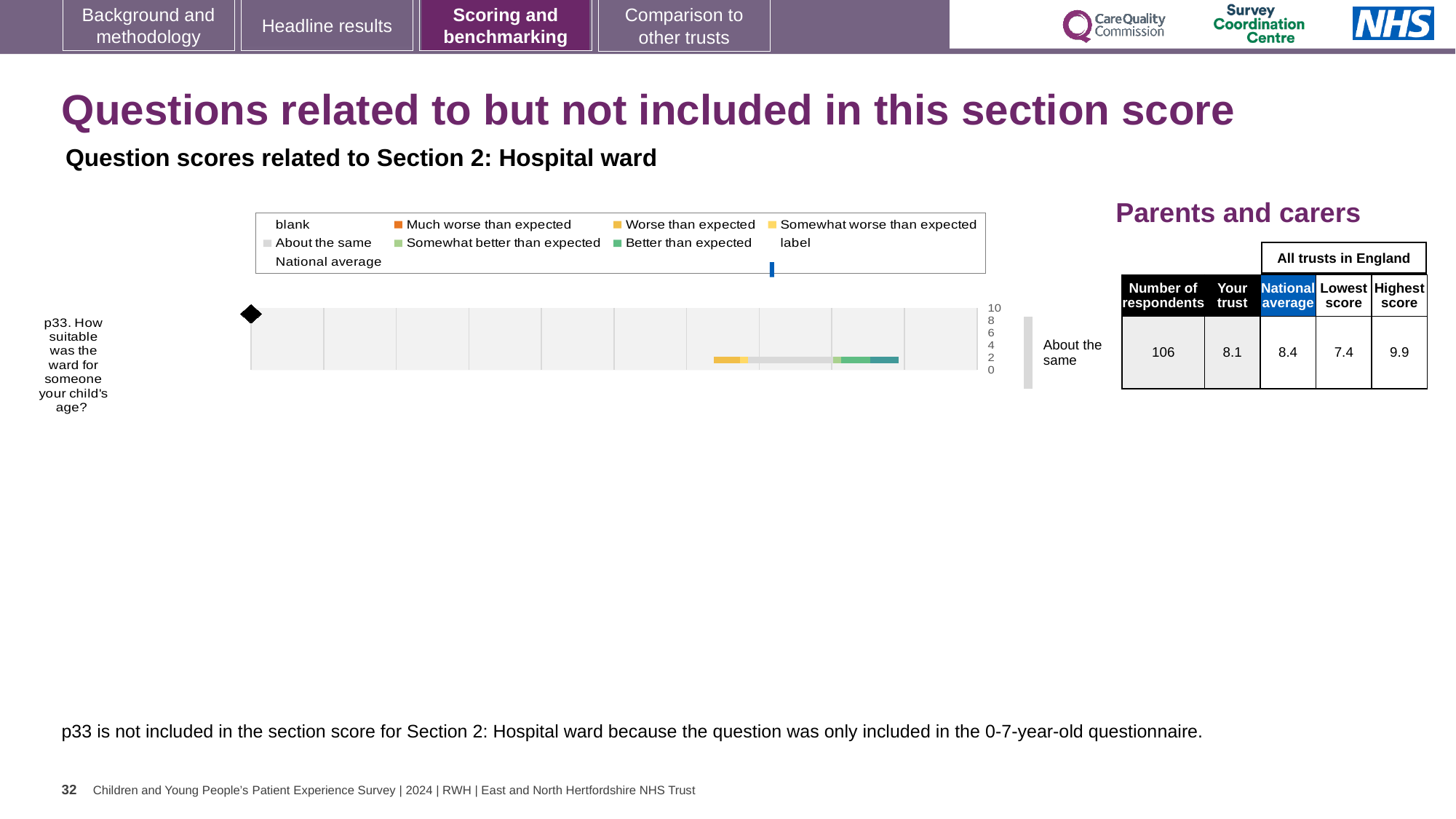
How many entries does the chart legend list? 9 In the table next to the chart, how many respondents answered p33? 106 What benchmark category label is shown to the right of the p33 bar? About the same For p33, what is the difference between the highest score and the lowest score among all trusts in England? 2.5 In the table next to the chart, what is the 'Your trust' score for p33? 8.1 In the table next to the chart, what is the highest score among all trusts in England for p33? 9.9 What kind of chart is shown for question p33? Bar chart In the table next to the chart, what is the lowest score among all trusts in England for p33? 7.4 How many survey questions are plotted in the chart? 1 For p33, which is larger: the 'Your trust' score or the national average? National average In the table next to the chart, what is the national average score for p33? 8.4 Which survey question is plotted in the chart? p33. How suitable was the ward for someone your child's age?